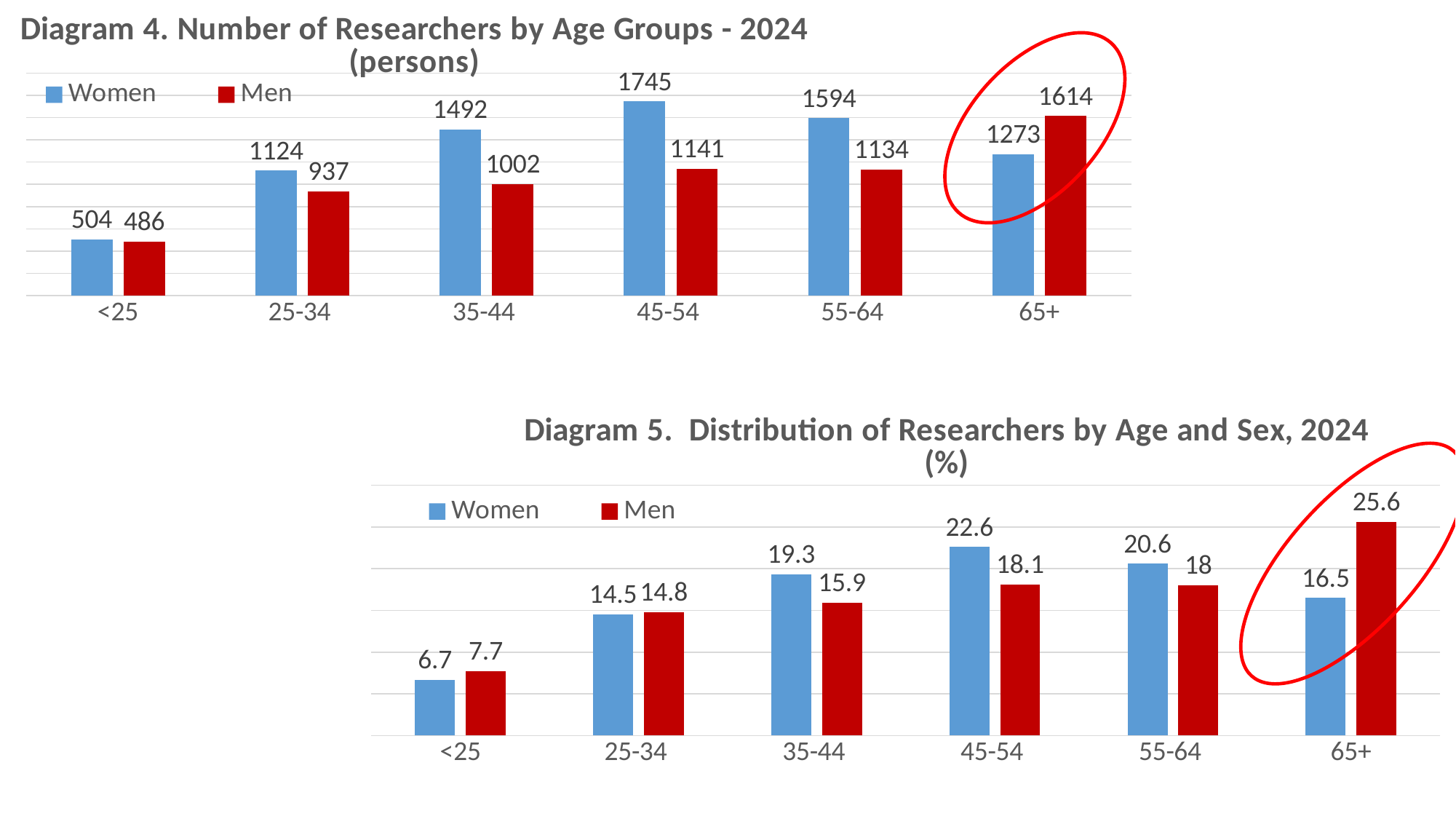
In Diagram 4 (Number of Researchers by Age Groups - 2024), what is the number of men researchers aged 65+? 1614 In Diagram 4 (Number of Researchers by Age Groups - 2024), what is the number of women researchers aged 45-54? 1745 In Diagram 5 (Distribution of Researchers by Age and Sex, 2024), which age group has the highest share of women researchers? 45-54 In Diagram 4 (Number of Researchers by Age Groups - 2024), which age group has the highest number of women researchers? 45-54 In Diagram 4 (Number of Researchers by Age Groups - 2024), are there more women or men researchers in the 65+ age group? Men In Diagram 4 (Number of Researchers by Age Groups - 2024), what is the difference between women and men researchers in the 35-44 age group? 490 How many series does the legend of Diagram 5 (Distribution of Researchers by Age and Sex, 2024) list? 2 In Diagram 5 (Distribution of Researchers by Age and Sex, 2024), what is the share of women researchers aged 35-44? 19.3 In Diagram 4 (Number of Researchers by Age Groups - 2024), which age group has the lowest number of men researchers? <25 In Diagram 4 (Number of Researchers by Age Groups - 2024), how many age groups are shown on the x axis? 6 In Diagram 5 (Distribution of Researchers by Age and Sex, 2024), what is the share of men researchers aged 65+? 25.6 In Diagram 5 (Distribution of Researchers by Age and Sex, 2024), what is the difference between the men and women shares in the 65+ age group? 9.1